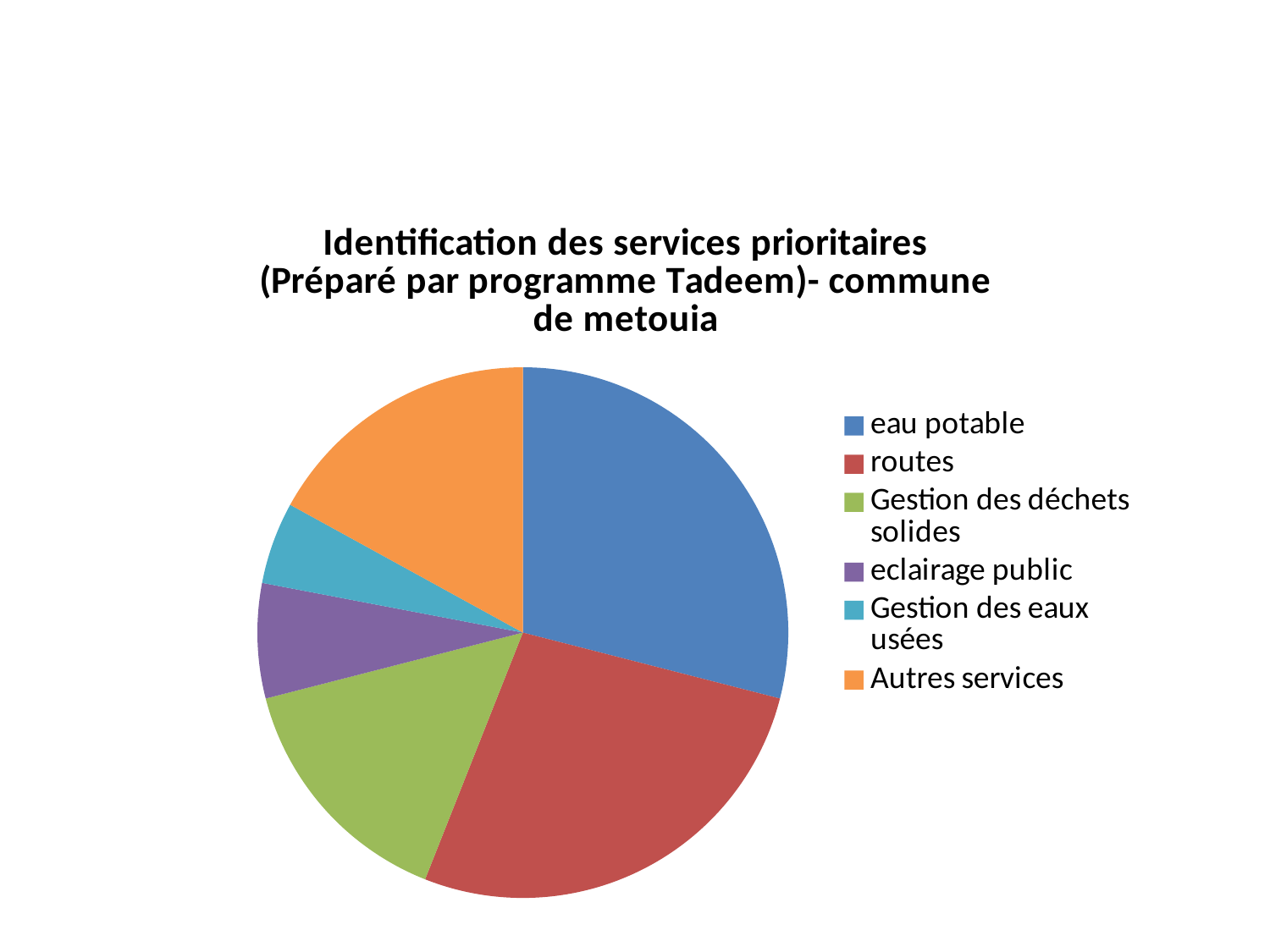
How many slices does the pie chart have? 6 What kind of chart is shown on the slide? pie chart Which is larger, the slice for Autres services or the slice for Gestion des eaux usées? Autres services Which is larger, the slice for routes or the slice for Gestion des eaux usées? routes Which is larger, the slice for Autres services or the slice for eclairage public? Autres services How many entries does the legend list? 6 What is the title of the chart? Identification des services prioritaires (Préparé par programme Tadeem)- commune de metouia What colour is the slice for routes? red